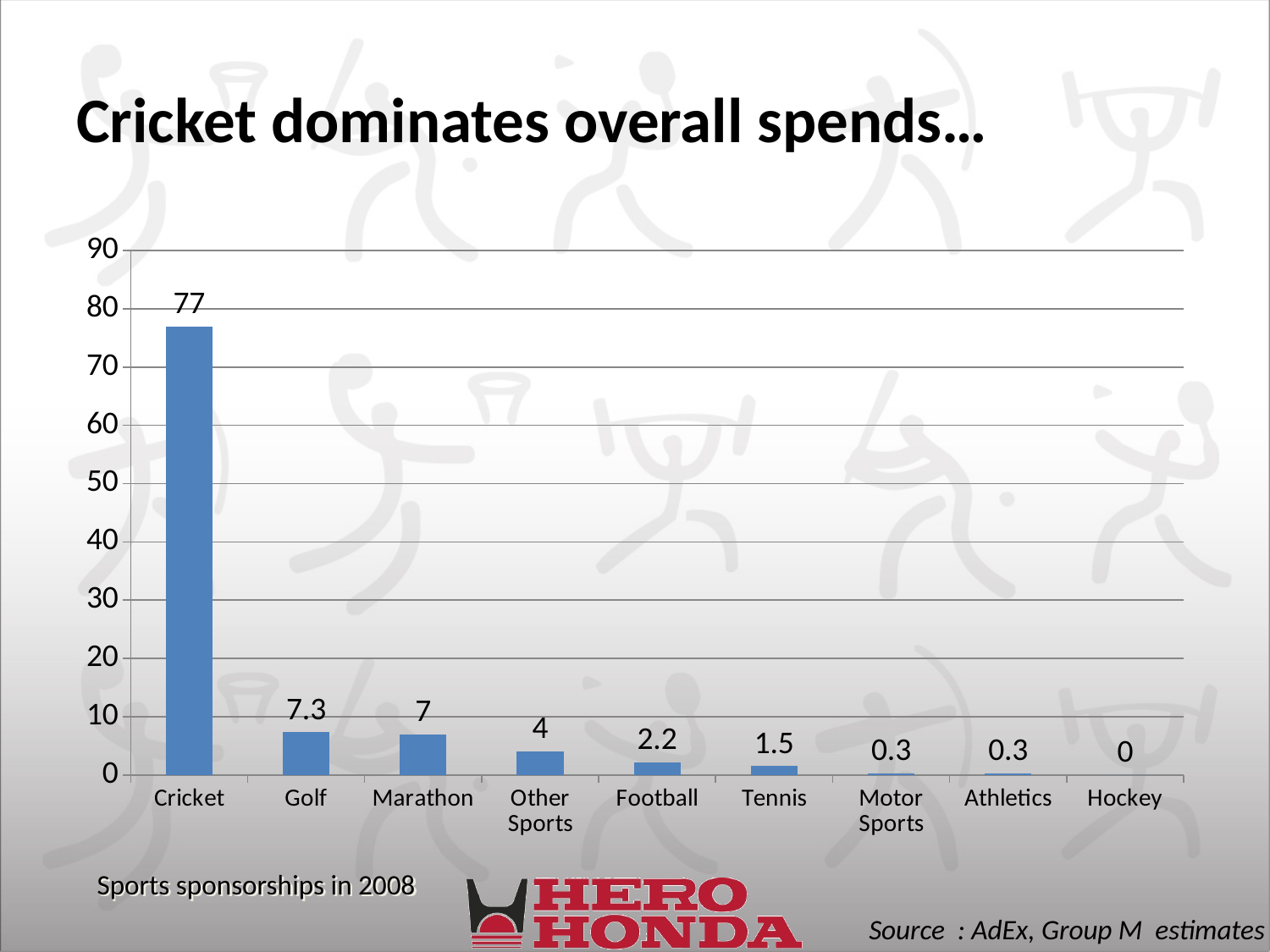
What is the title of the slide? Cricket dominates overall spends... What is the difference between the values for Cricket and Golf? 69.7 What is the value for Hockey? 0 What is the value for Football? 2.2 How many categories are shown on the x axis? 9 What is the value for Cricket? 77 What kind of chart is shown on the slide? Bar chart Which category has the highest value? Cricket Which is larger, the value for Golf or the value for Marathon? Golf What is the difference between the values for Marathon and Other Sports? 3 What is the value for Golf? 7.3 Which category has the lowest value? Hockey